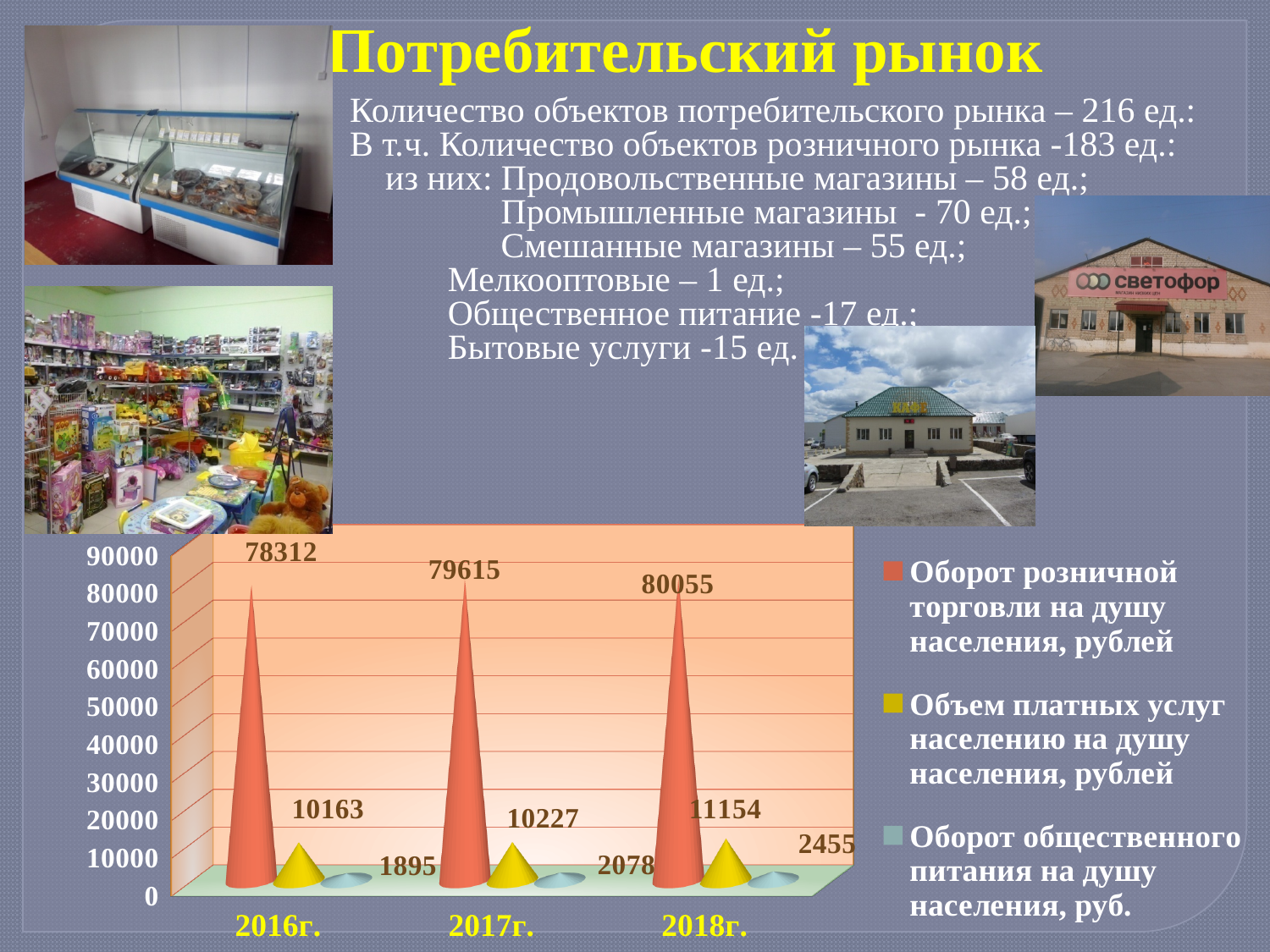
Is the value of 'Оборот розничной торговли на душу населения, рублей' for 2017г. greater or less than 70000? greater What is the difference between 'Оборот розничной торговли на душу населения, рублей' in 2018г. and in 2016г.? 1743 In which year is 'Оборот общественного питания на душу населения, руб.' the lowest? 2016г. How many series does the chart legend list? 3 In which year is 'Оборот розничной торговли на душу населения, рублей' the highest? 2018г. How many years are shown on the x axis of the chart? 3 What colour represents 'Объем платных услуг населению на душу населения, рублей' in the chart? yellow What is the value of 'Оборот розничной торговли на душу населения, рублей' for 2016г.? 78312 Which is larger: 'Объем платных услуг населению на душу населения, рублей' in 2017г. or in 2018г.? 2018г. Does 'Оборот общественного питания на душу населения, руб.' rise or fall from 2016г. to 2018г.? rise What is the value of 'Оборот общественного питания на душу населения, руб.' for 2017г.? 2078 What is the value of 'Объем платных услуг населению на душу населения, рублей' for 2018г.? 11154